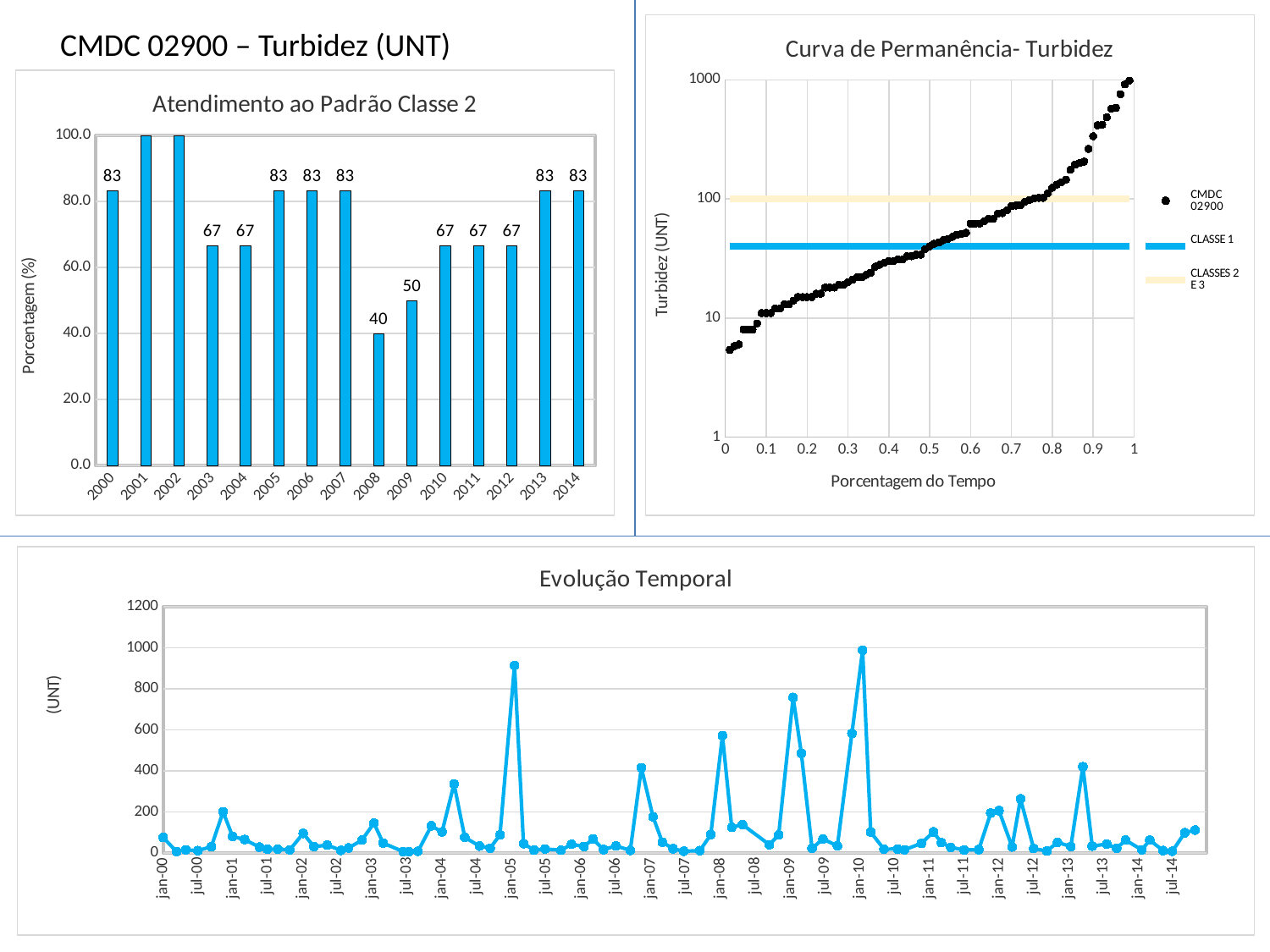
In the 'Curva de Permanência- Turbidez' chart, what is the x-axis title? Porcentagem do Tempo In the 'Atendimento ao Padrão Classe 2' chart, which year has the lowest value? 2008 In the 'Curva de Permanência- Turbidez' chart, how many series does the legend list? 3 In the 'Atendimento ao Padrão Classe 2' chart, what is the difference between the values for 2000 and 2008? 43 What kind of chart is 'Atendimento ao Padrão Classe 2'? bar chart In the 'Atendimento ao Padrão Classe 2' chart, what is the value for 2008? 40 What kind of chart is 'Evolução Temporal'? line chart In the 'Evolução Temporal' chart, is the peak value near jan-10 greater or less than 800? greater In the 'Atendimento ao Padrão Classe 2' chart, which is larger, the value for 2009 or the value for 2010? 2010 In the 'Atendimento ao Padrão Classe 2' chart, is the value for 2001 greater or less than 80? greater In the 'Atendimento ao Padrão Classe 2' chart, what is the value for 2009? 50 In the 'Atendimento ao Padrão Classe 2' chart, how many years are shown on the x axis? 15